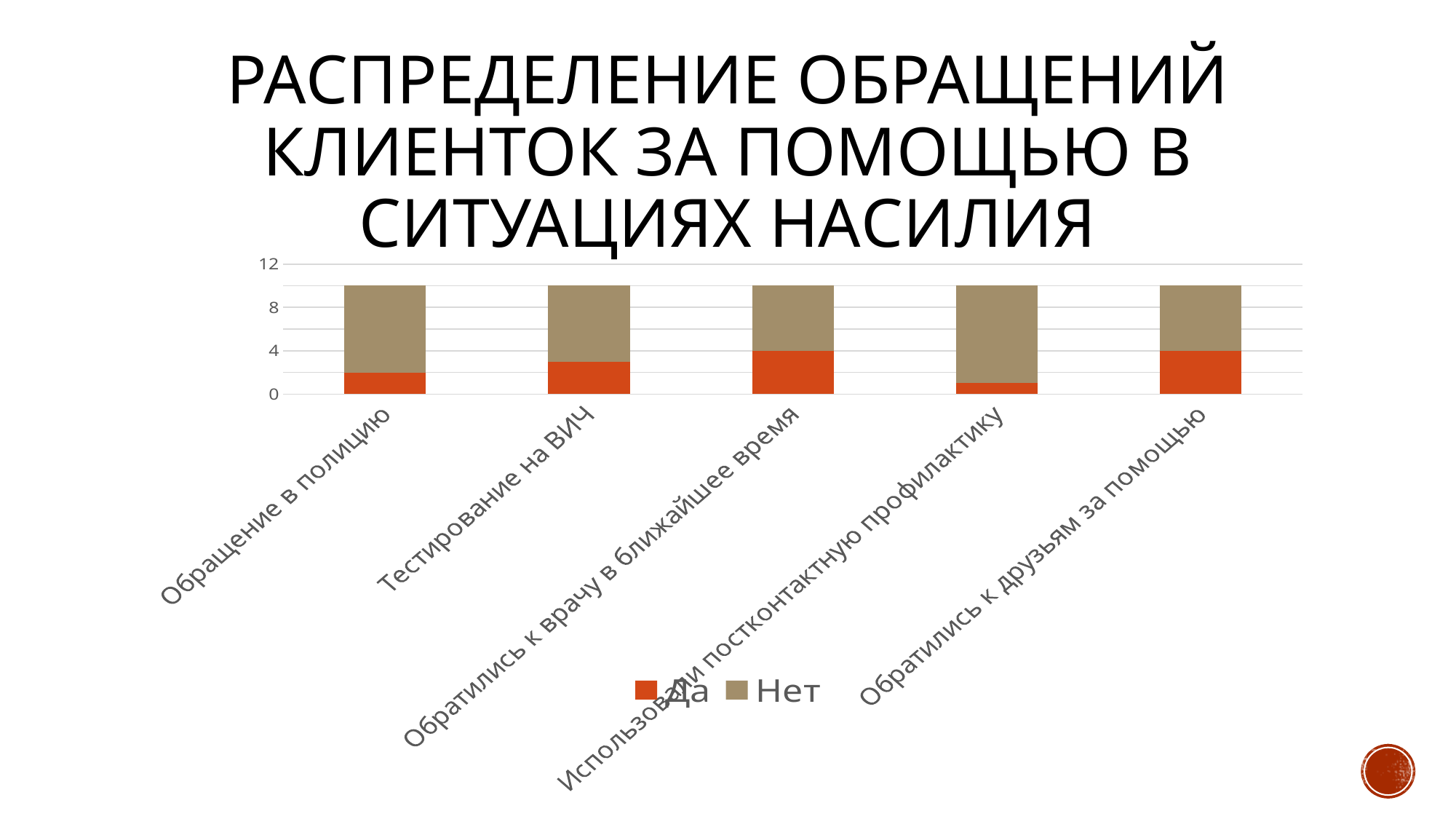
How many series does the chart legend list? 2 Is the "Да" value for "Использовали постконтактную профилактику" greater or less than 4? less What is the value of the "Да" series for "Обратились к друзьям за помощью"? 4 Which category has the lowest "Да" value? Использовали постконтактную профилактику Is the "Да" value for "Обращение в полицию" greater or less than 4? less What are the two series named in the legend? Да, Нет Which has the larger "Нет" value: "Обращение в полицию" or "Обратились к друзьям за помощью"? Обращение в полицию What kind of chart is shown on the slide? bar chart How many categories are shown along the x axis of the chart? 5 Is the total height of the stacked bar for "Тестирование на ВИЧ" greater or less than 8? greater Which has the larger "Да" value: "Обращение в полицию" or "Обратились к врачу в ближайшее время"? Обратились к врачу в ближайшее время What is the value of the "Да" series for "Обратились к врачу в ближайшее время"? 4